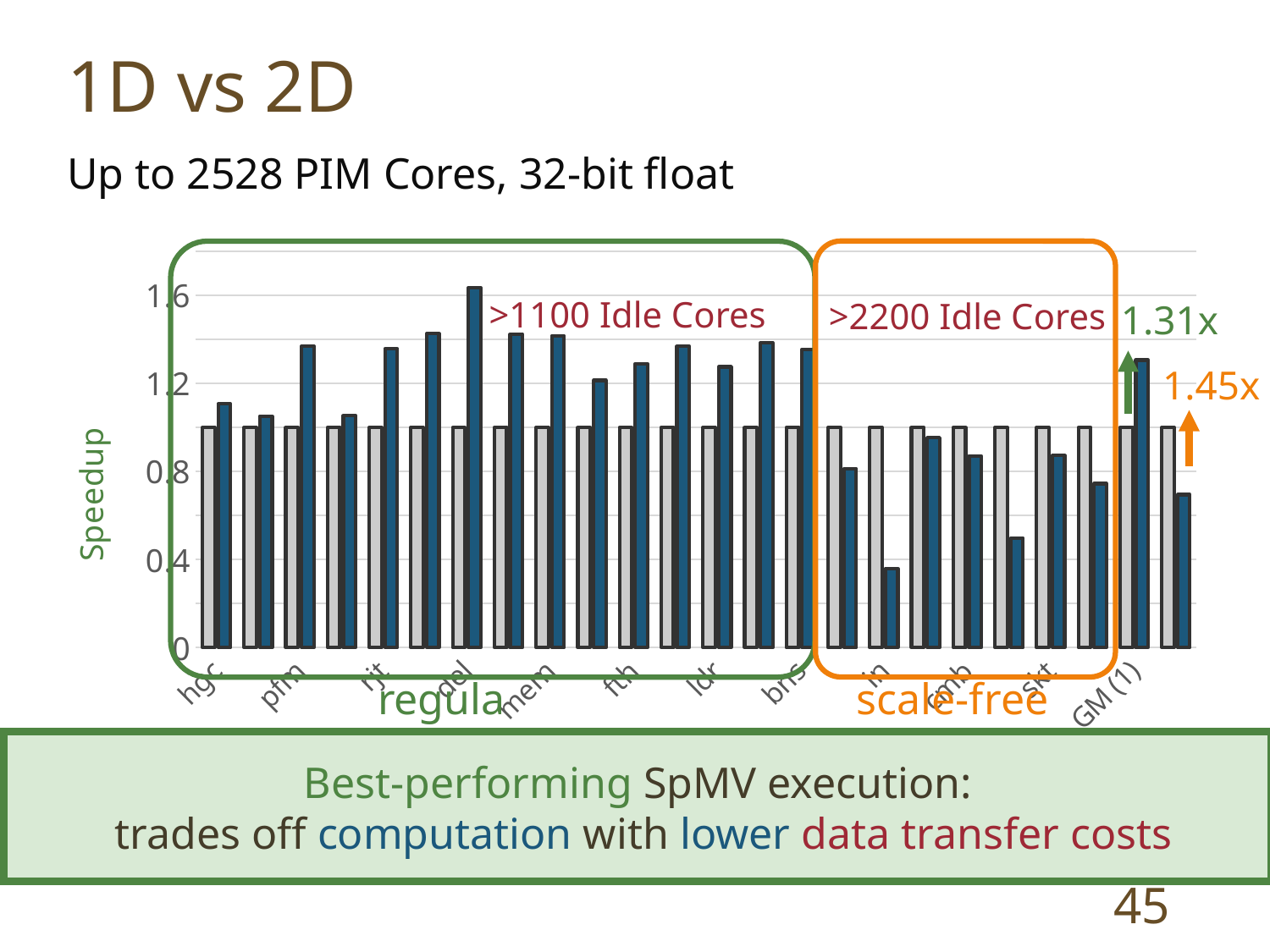
What speedup value is annotated in green next to the GM bars? 1.31x Is the blue bar for rjt greater or less than 1.2? greater What kind of chart is shown on the slide? bar chart What is the label of the y axis? Speedup Is the blue bar for hgc greater or less than 0.8? greater Which has the taller blue bar, del or hgc? del Which has the taller blue bar, mem or in? mem What are the two groups of categories labelled below the x axis? regular and scale-free Is the blue bar for pfm greater or less than 1.2? greater Which category has the tallest blue bar? del